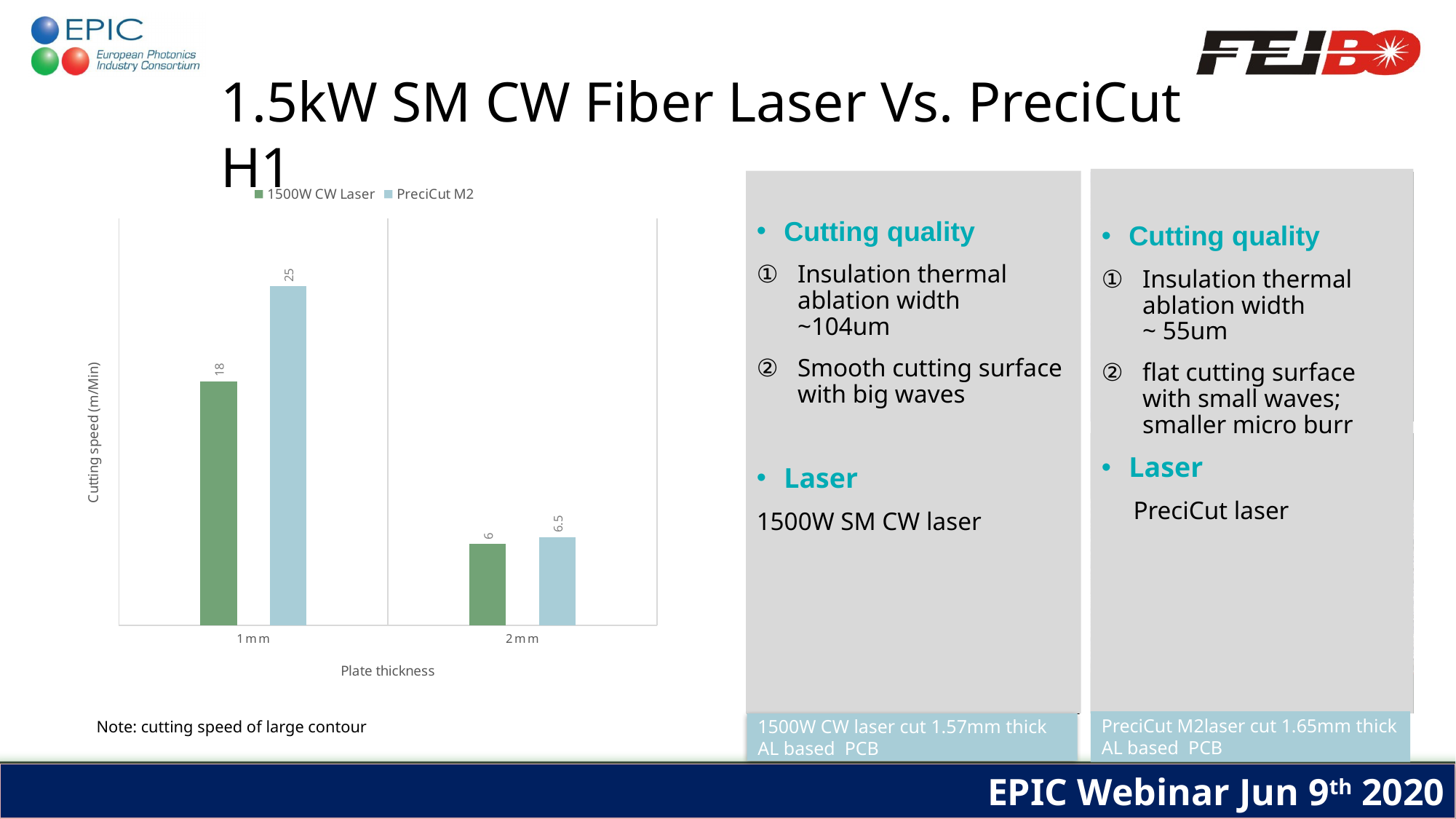
What is the difference in cutting speed between PreciCut M2 and the 1500W CW Laser at 1mm plate thickness? 7 What is the cutting speed of PreciCut M2 at 1mm plate thickness? 25 What type of chart is shown on the slide? Bar chart Which bar in the chart has the highest value? PreciCut M2 at 1mm What is the cutting speed of PreciCut M2 at 2mm plate thickness? 6.5 How many series does the legend list? 2 How many plate thickness categories are shown on the x axis? 2 What is the cutting speed of the 1500W CW Laser at 1mm plate thickness? 18 Which series has the higher cutting speed at 1mm plate thickness? PreciCut M2 Which bar in the chart has the lowest value? 1500W CW Laser at 2mm What is the cutting speed of the 1500W CW Laser at 2mm plate thickness? 6 What is the difference in cutting speed between PreciCut M2 and the 1500W CW Laser at 2mm plate thickness? 0.5